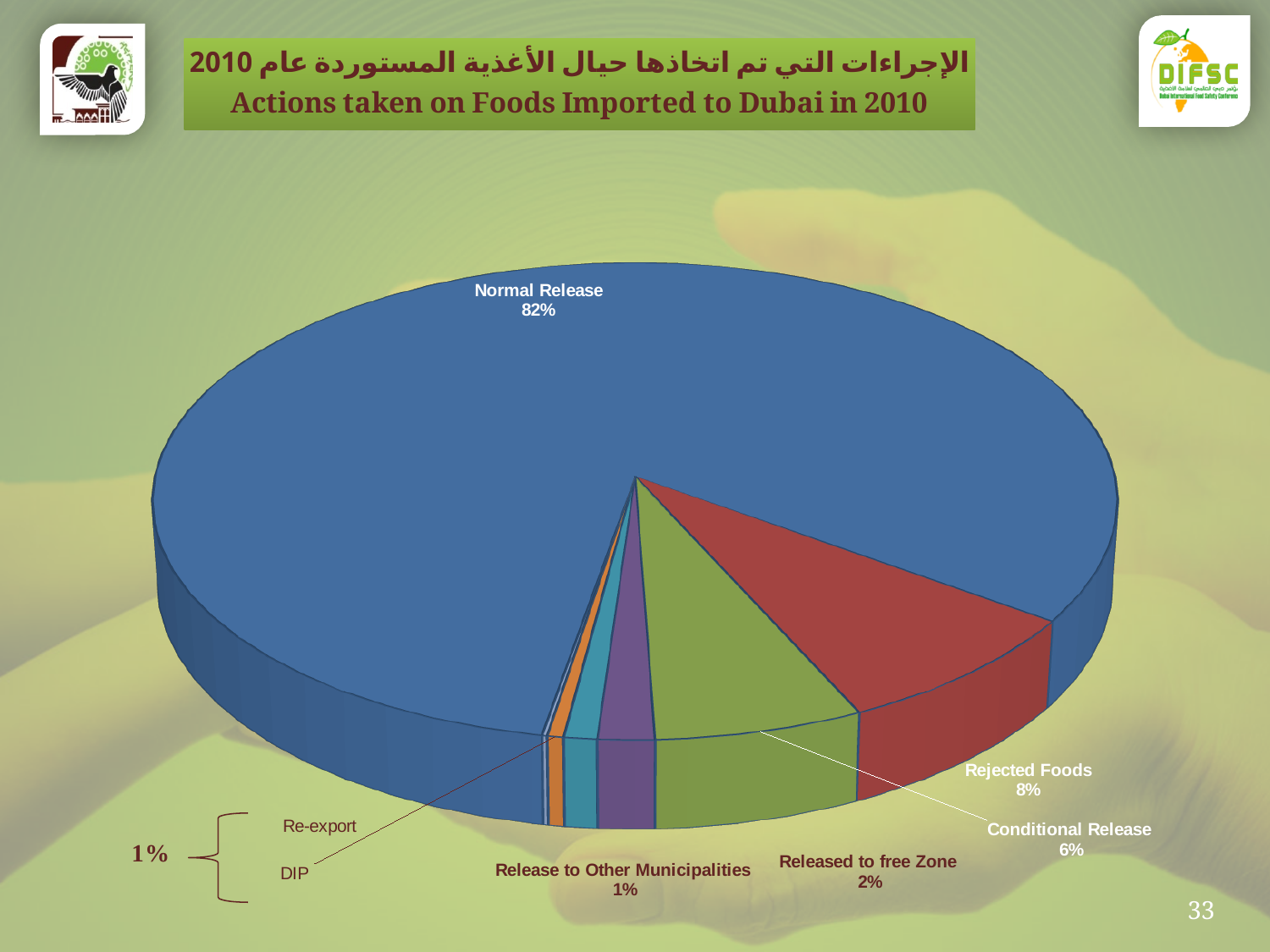
Which category has the largest slice of the pie? Normal Release How many percentage points larger is Rejected Foods than Conditional Release? 2 percentage points What percentage is shown for Conditional Release? 6% What combined percentage is shown by the bracket for Re-export and DIP? 1% What share of the pie is Rejected Foods? 8% What kind of chart is shown on the slide? Pie chart What is the English title of the chart? Actions taken on Foods Imported to Dubai in 2010 What percentage is shown for Released to free Zone? 2% What percentage of the pie is Normal Release? 82% What percentage is shown for Release to Other Municipalities? 1% Which is larger, Rejected Foods or Conditional Release? Rejected Foods How many percentage points larger is Normal Release than Rejected Foods? 74 percentage points